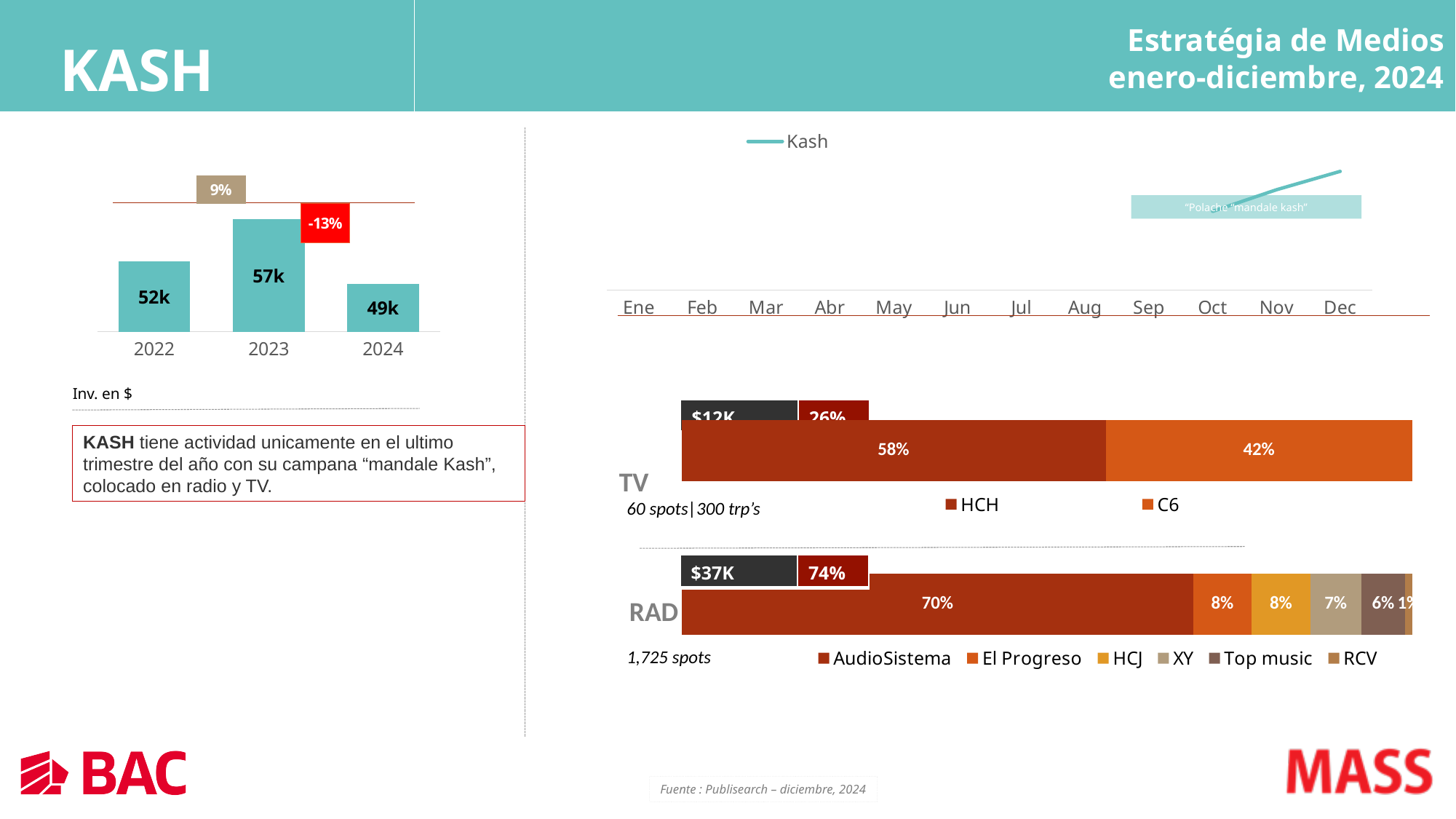
What kind of chart is the chart on the left of the slide showing values by year? bar chart In the RAD stacked bar chart, what is the difference between the AudioSistema and XY shares? 63% In the TV stacked bar chart, what share does HCH have? 58% How many series does the legend of the RAD stacked bar chart list? 6 In the RAD stacked bar chart, what share does AudioSistema have? 70% In the bar chart on the left of the slide, which year has the highest value? 2023 In the bar chart on the left of the slide, what is the value for 2024? 49k In the bar chart on the left of the slide, what is the value for 2023? 57k In the bar chart on the left of the slide, which year has the lowest value? 2024 In the bar chart on the left of the slide, how many years are shown? 3 In the bar chart on the left of the slide, what is the difference between the 2023 and 2022 values? 5k In the TV stacked bar chart, which is larger, HCH or C6? HCH